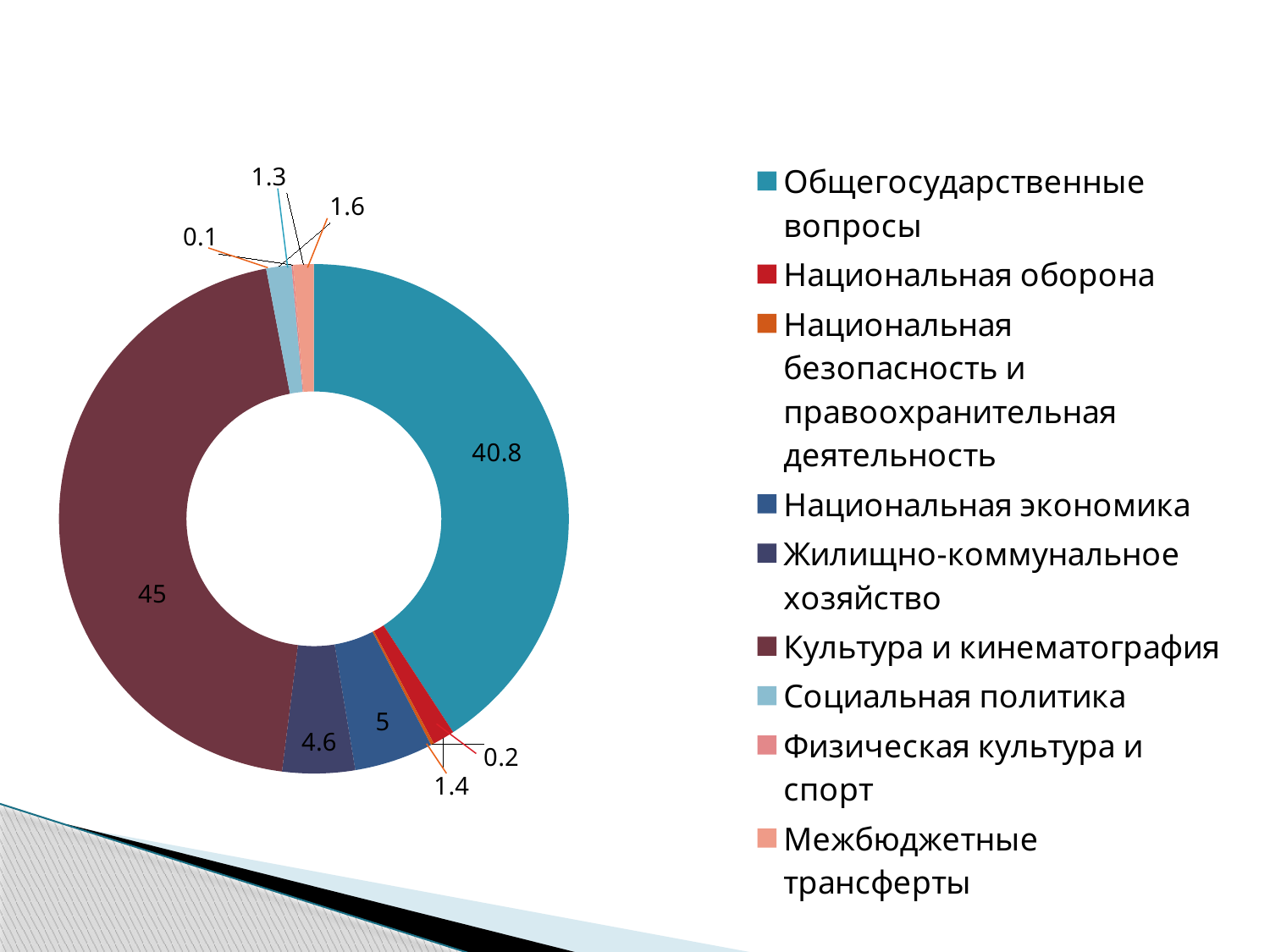
What is the value for Жилищно-коммунальное хозяйство? 4.6 How many categories does the legend of the chart list? 9 What is the value for Культура и кинематография? 45 What is the value for Общегосударственные вопросы? 40.8 What kind of chart is shown on the slide? doughnut chart Which category has the largest slice? Культура и кинематография Which category has the smallest slice? Физическая культура и спорт Which is larger, the value for Национальная оборона or the value for Национальная безопасность и правоохранительная деятельность? Национальная оборона What is the difference between the values for Культура и кинематография and Общегосударственные вопросы? 4.2 What colour is the slice for Общегосударственные вопросы? teal What is the value for Межбюджетные трансферты? 1.3 What is the value for Национальная экономика? 5